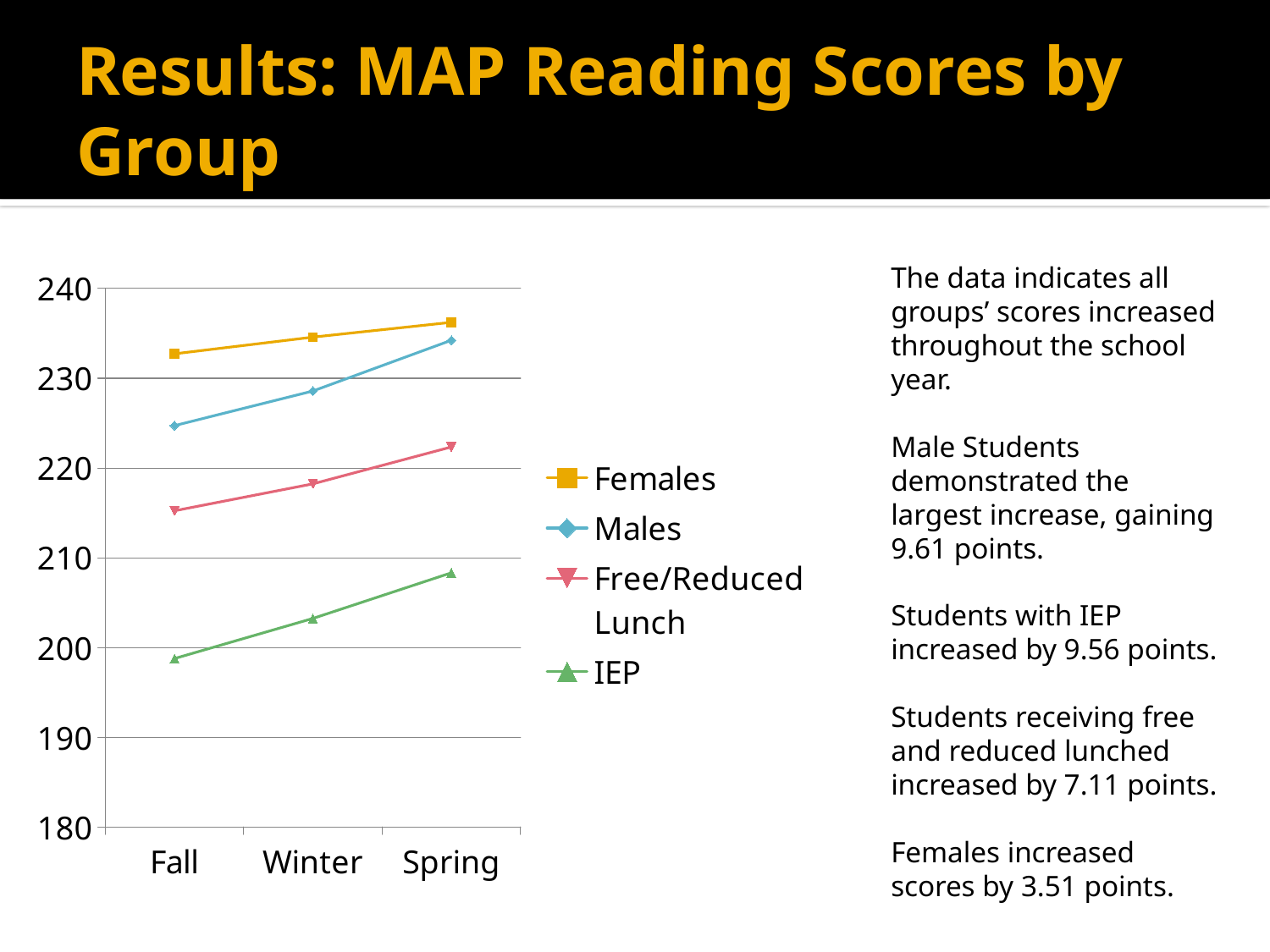
Which group has the highest score in Fall? Females Is the Males value for Spring greater or less than 230? greater Is the Free/Reduced Lunch value for Fall greater or less than 220? less Do the IEP scores rise or fall from Fall to Spring? rise Is the Females value for Winter greater or less than 230? greater What kind of chart is shown on the slide? line chart What are the entries listed in the chart's legend? Females, Males, Free/Reduced Lunch, IEP How many series does the legend list? 4 Which group has the lowest score in Spring? IEP In Winter, which is larger: the Males score or the Free/Reduced Lunch score? Males How many points are on the x axis of the chart? 3